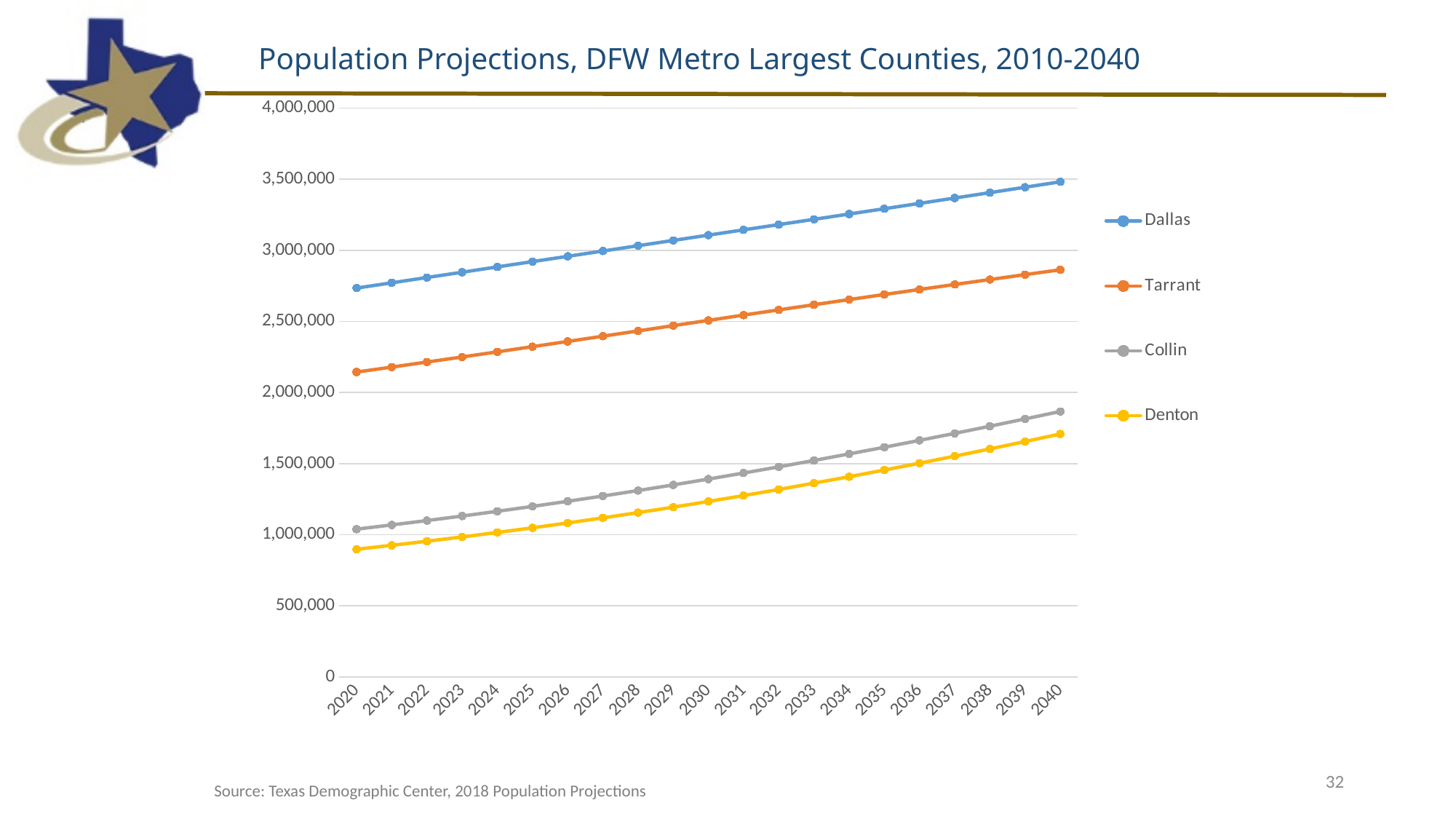
Which county has the highest projected population in 2040? Dallas How many series does the legend list? 4 How many years are plotted along the x axis? 21 Which county has the lowest projected population in 2020? Denton Is the value for Denton in 2020 greater or less than 1,000,000? less Is the value for Collin in 2040 greater or less than 2,000,000? less Is the value for Dallas in 2020 greater or less than 2,500,000? greater In 2030, which is larger, the value for Dallas or the value for Tarrant? Dallas What kind of chart is shown on the slide? line chart Does the Collin line rise or fall from 2020 to 2040? rise What is the title of the chart? Population Projections, DFW Metro Largest Counties, 2010-2040